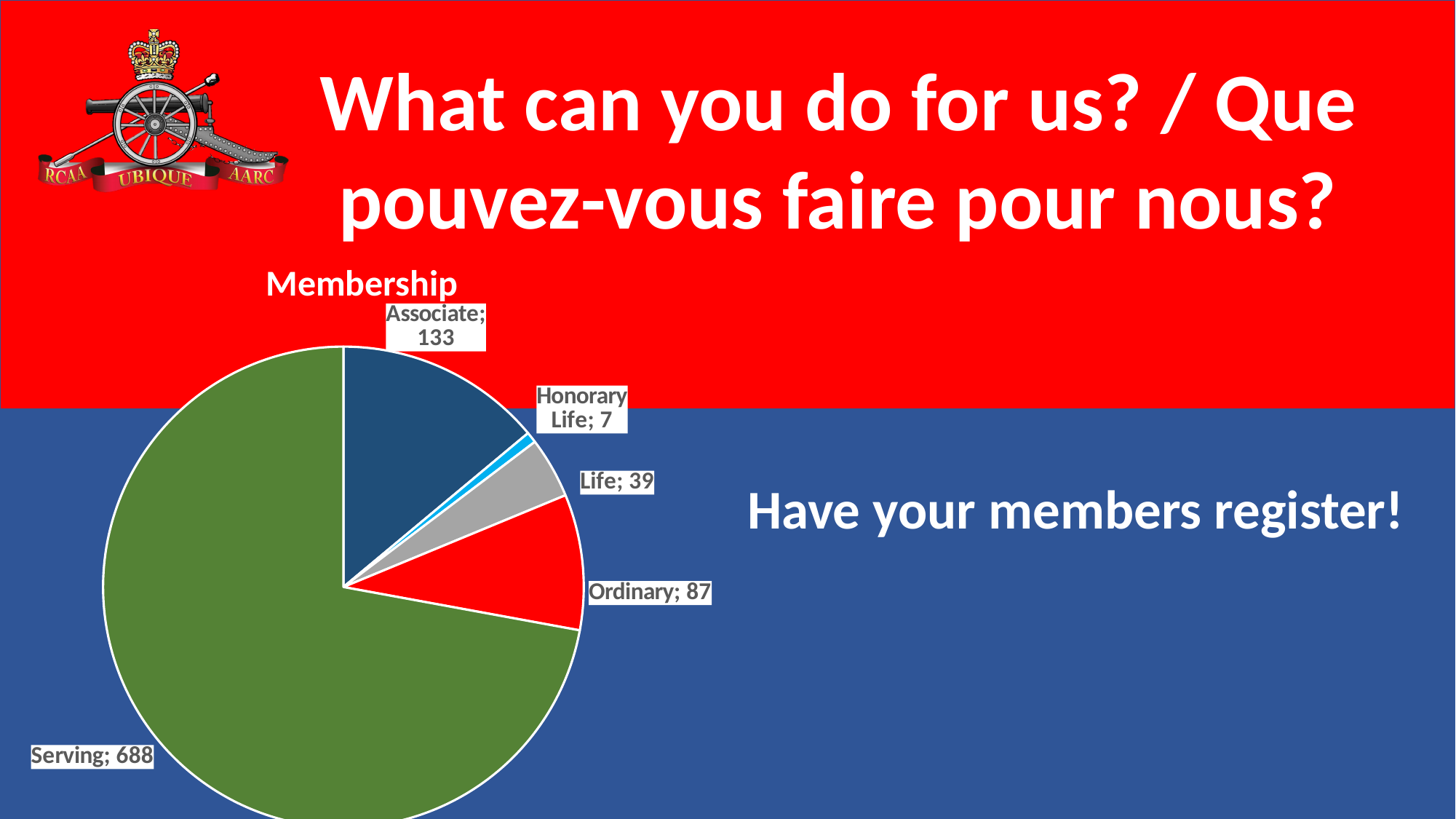
Which category has the smallest slice in the Membership chart? Honorary Life How many categories does the Membership pie chart show? 5 What type of chart is shown on the slide? pie chart What is the value for Ordinary in the Membership chart? 87 Which is larger in the Membership chart, Life or Ordinary? Ordinary What is the value for Associate in the Membership chart? 133 What is the title of the chart? Membership What is the value for Honorary Life in the Membership chart? 7 Which category has the largest slice in the Membership chart? Serving What is the value for Serving in the Membership chart? 688 What is the total of all categories in the Membership chart? 954 What is the difference between the Associate and Ordinary values in the Membership chart? 46